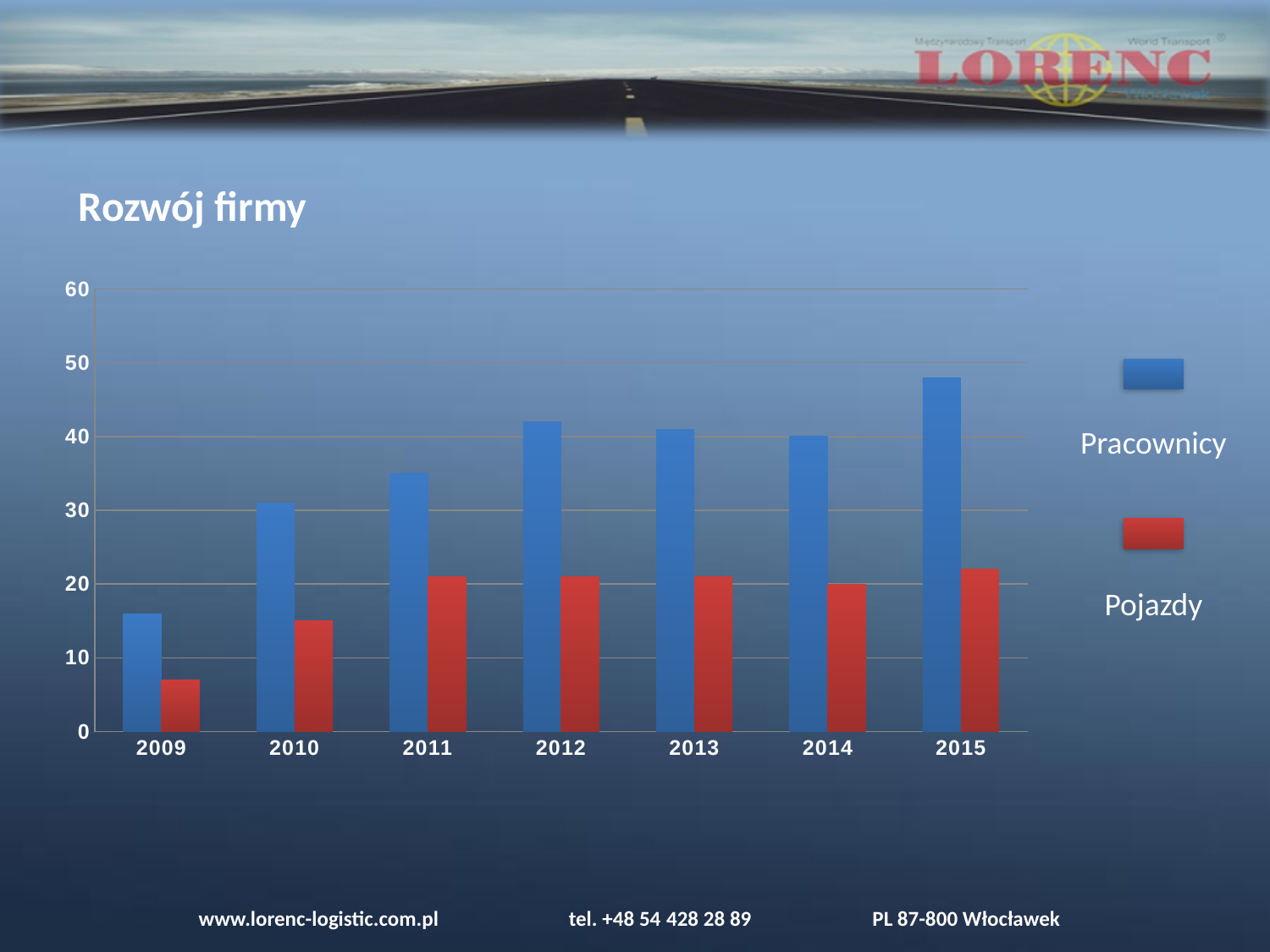
Which is larger, the Pracownicy value for 2010 or for 2011? 2011 How many series does the chart legend list? 2 Is the Pracownicy value for 2015 greater or less than 50? less In which year is the Pracownicy value highest? 2015 What kind of chart is shown on the slide? bar chart How many years are shown on the x axis of the chart? 7 Is the Pojazdy value for 2009 greater or less than 10? less What is the title of the chart on the slide? Rozwój firmy Is the Pracownicy value for 2009 greater or less than 20? less In which year is the Pracownicy value lowest? 2009 In which year is the Pojazdy value lowest? 2009